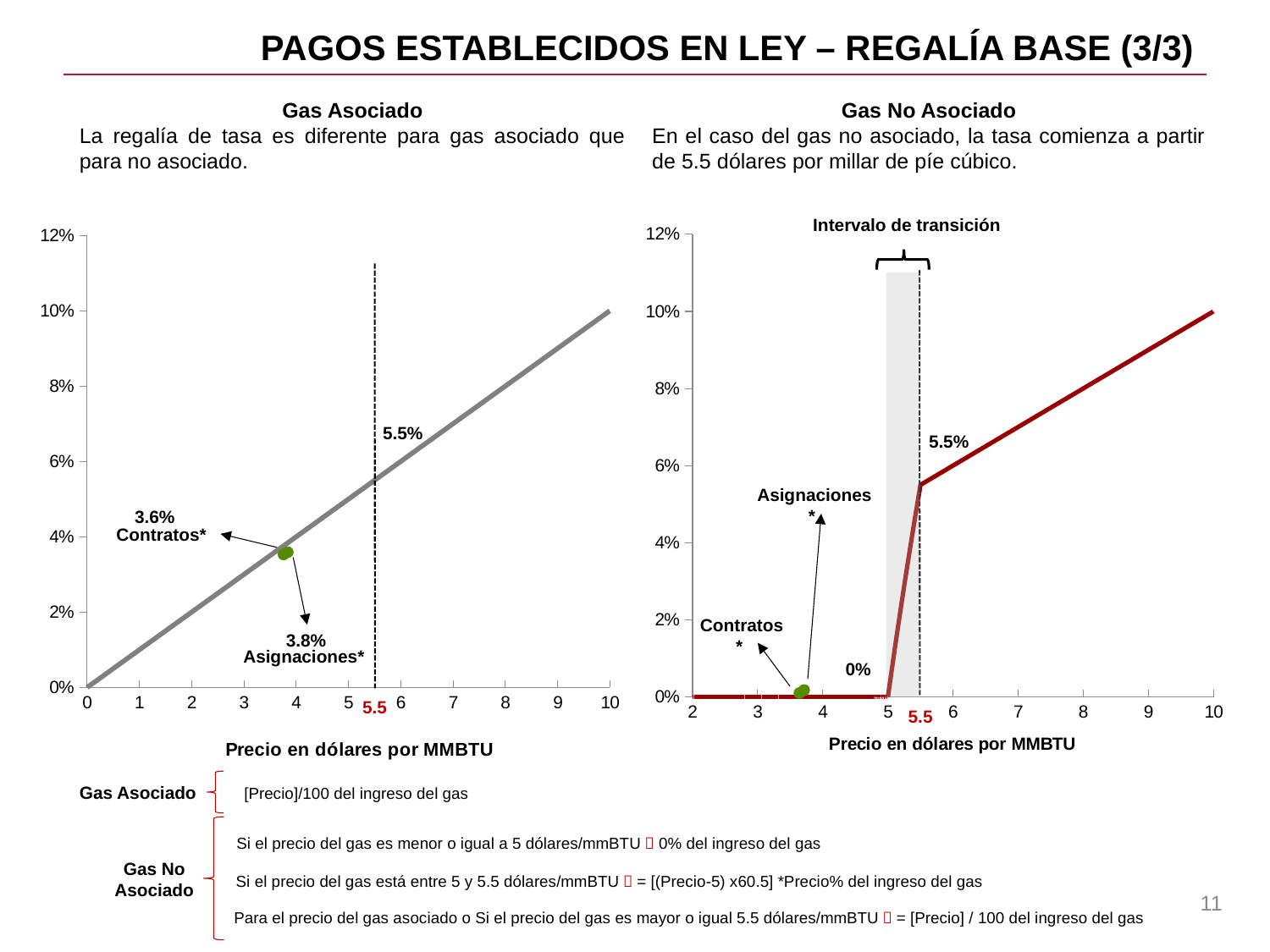
On the Gas Asociado chart on the left, what is the difference between the labelled rates for Asignaciones* and Contratos*? 0.2% What kind of chart is the Gas Asociado chart on the left? Line chart On the Gas Asociado chart on the left, what royalty rate is labelled at the dashed line at a price of 5.5? 5.5% On the Gas Asociado chart on the left, what rate is labelled for Asignaciones*? 3.8% On the Gas Asociado chart on the left, which labelled rate is larger, Contratos* or Asignaciones*? Asignaciones* On the Gas No Asociado chart on the right, is the rate at a price of 4 greater or less than 2%? less On the Gas Asociado chart on the left, does the royalty rate rise or fall as the price increases along the x axis? Rises On the Gas Asociado chart on the left, what rate is labelled for Contratos*? 3.6% On the Gas No Asociado chart on the right, what rate is labelled at the dashed line at a price of 5.5? 5.5% On the Gas No Asociado chart on the right, what rate is labelled for prices below 5 dollars? 0% On the Gas No Asociado chart on the right, what is the shaded region between prices 5 and 5.5 labelled? Intervalo de transición On the Gas Asociado chart on the left, is the rate at a price of 8 greater or less than 6%? greater